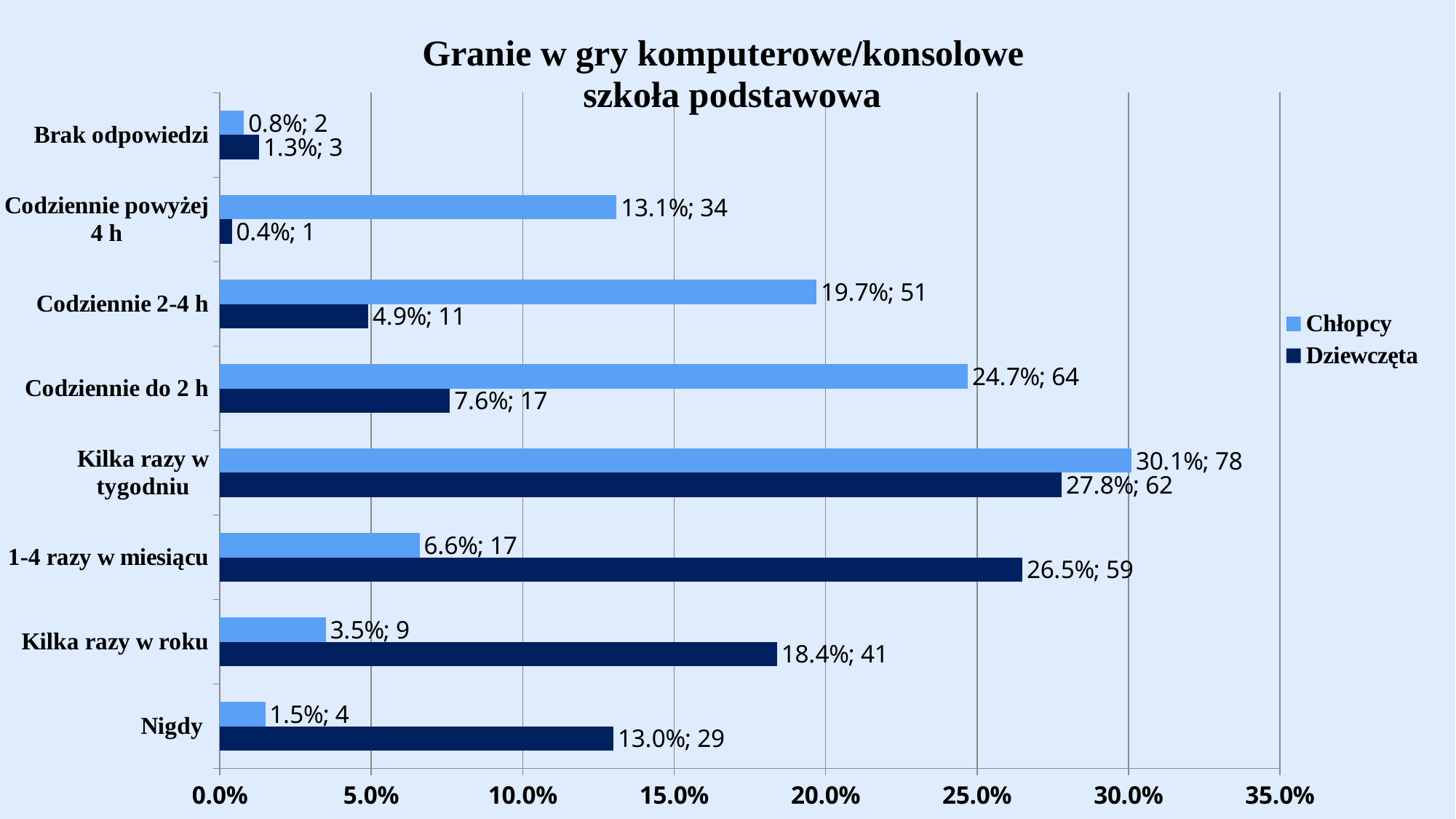
Which category has the lowest percentage for Dziewczęta? Codziennie powyżej 4 h How many Dziewczęta answered '1-4 razy w miesiącu'? 59 What percentage of Chłopcy play computer/console games 'Kilka razy w tygodniu'? 30.1% What is the difference in percentage points between Chłopcy and Dziewczęta for 'Codziennie 2-4 h'? 14.8 Is the value for Dziewczęta in 'Kilka razy w tygodniu' greater or less than 25.0%? greater What is the title of the chart? Granie w gry komputerowe/konsolowe szkoła podstawowa How many response categories are shown on the chart? 8 For 'Kilka razy w roku', which group has the larger percentage, Chłopcy or Dziewczęta? Dziewczęta What type of chart is shown on the slide? Bar chart How many series does the legend list? 2 What percentage of Dziewczęta answered 'Nigdy'? 13.0% Which category has the highest percentage for Chłopcy? Kilka razy w tygodniu